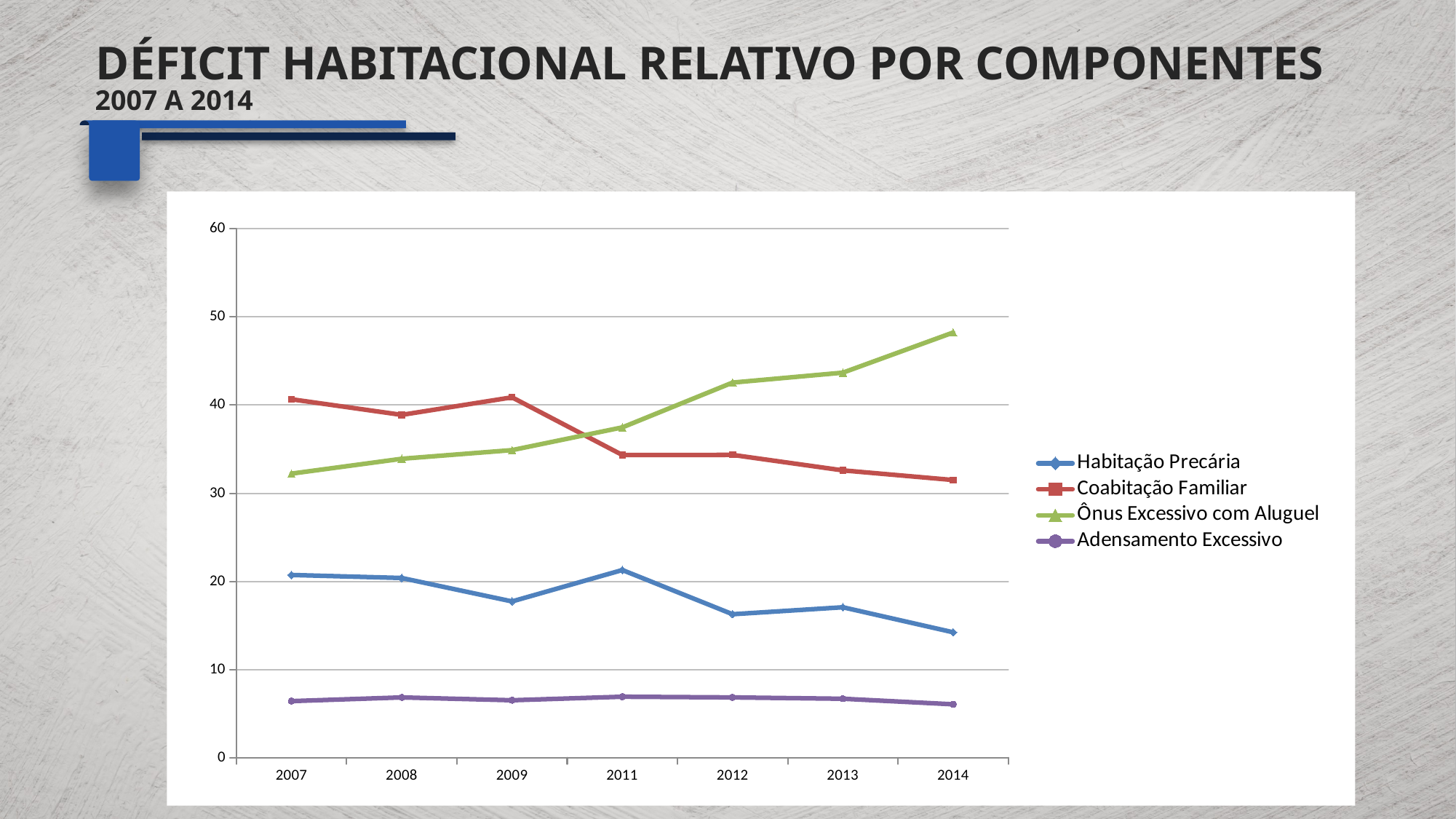
Is the value for Ônus Excessivo com Aluguel in 2014 greater or less than 40? greater What kind of chart is shown on the slide? line chart Does the value for Habitação Precária rise or fall overall from 2007 to 2014? fall How many series does the legend list? 4 In 2011, which is larger: Coabitação Familiar or Ônus Excessivo com Aluguel? Ônus Excessivo com Aluguel Which series has the lowest value in 2007? Adensamento Excessivo Is the value for Habitação Precária in 2014 greater or less than 20? less Is the value for Adensamento Excessivo in 2007 greater or less than 10? less Which series has the highest value in 2014? Ônus Excessivo com Aluguel How many years are shown on the x axis? 7 Does the value for Ônus Excessivo com Aluguel rise or fall from 2007 to 2014? rise